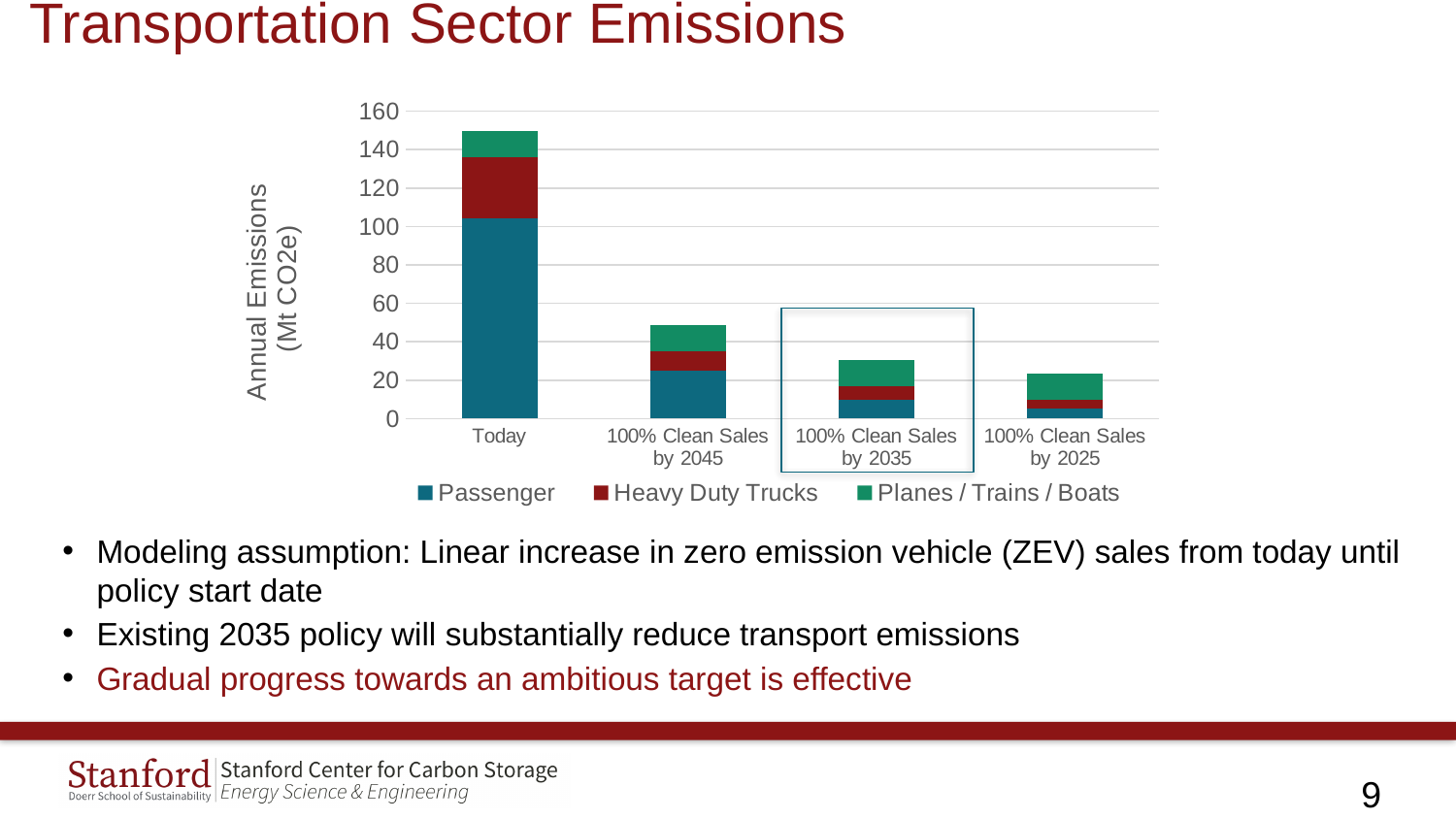
What is the label of the chart's y axis? Annual Emissions (Mt CO2e) Do the total annual emissions rise or fall moving from left to right across the categories? Fall Is the total annual emissions value for 100% Clean Sales by 2045 greater or less than 60? less What kind of chart is shown on the slide? Stacked bar chart Is the total annual emissions value for Today greater or less than 140? greater How many categories are shown on the x axis of the chart? 4 Which category has the highest total annual emissions? Today Is the Passenger value for Today greater or less than 100? greater Which has higher total annual emissions: 100% Clean Sales by 2045 or 100% Clean Sales by 2035? 100% Clean Sales by 2045 How many series does the chart's legend list? 3 Which category has the lowest total annual emissions? 100% Clean Sales by 2025